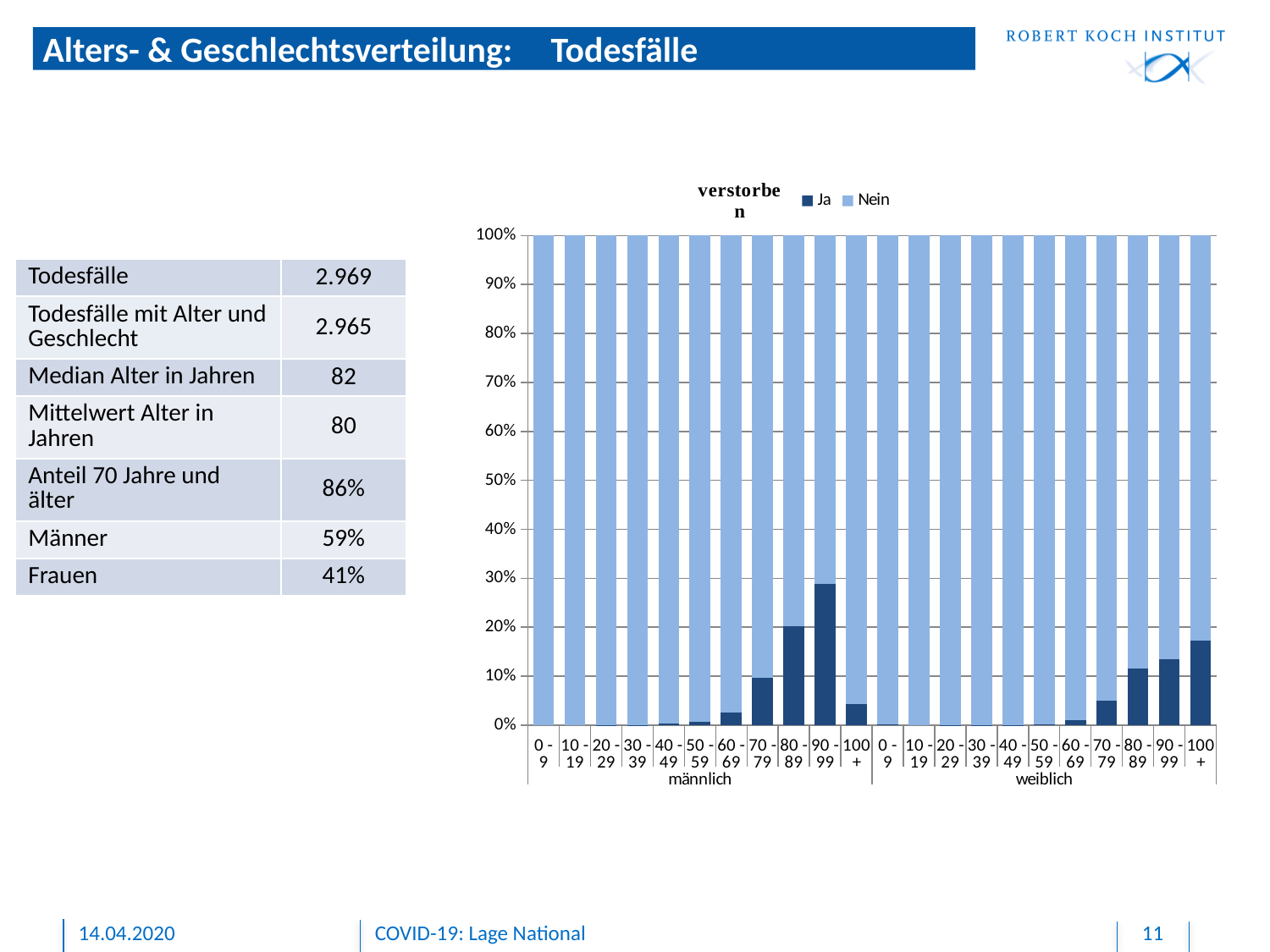
How many bars (age-group categories) are plotted in the chart in total? 22 What is the title of the chart? verstorben Which has the larger 'Ja' share: männlich 80 - 89 or weiblich 80 - 89? männlich 80 - 89 What are the two series named in the chart legend? Ja and Nein How many series does the chart legend list? 2 Which bar has the largest 'Ja' share in the chart? männlich 90 - 99 Is the 'Ja' share for weiblich 90 - 99 greater or less than 10%? greater What kind of chart is shown on the slide? bar chart Is the 'Ja' share for männlich 90 - 99 greater or less than 20%? greater Is the 'Ja' share for weiblich 100+ greater or less than 20%? less Within the männlich group, does the 'Ja' share rise or fall from 60 - 69 to 90 - 99? rise